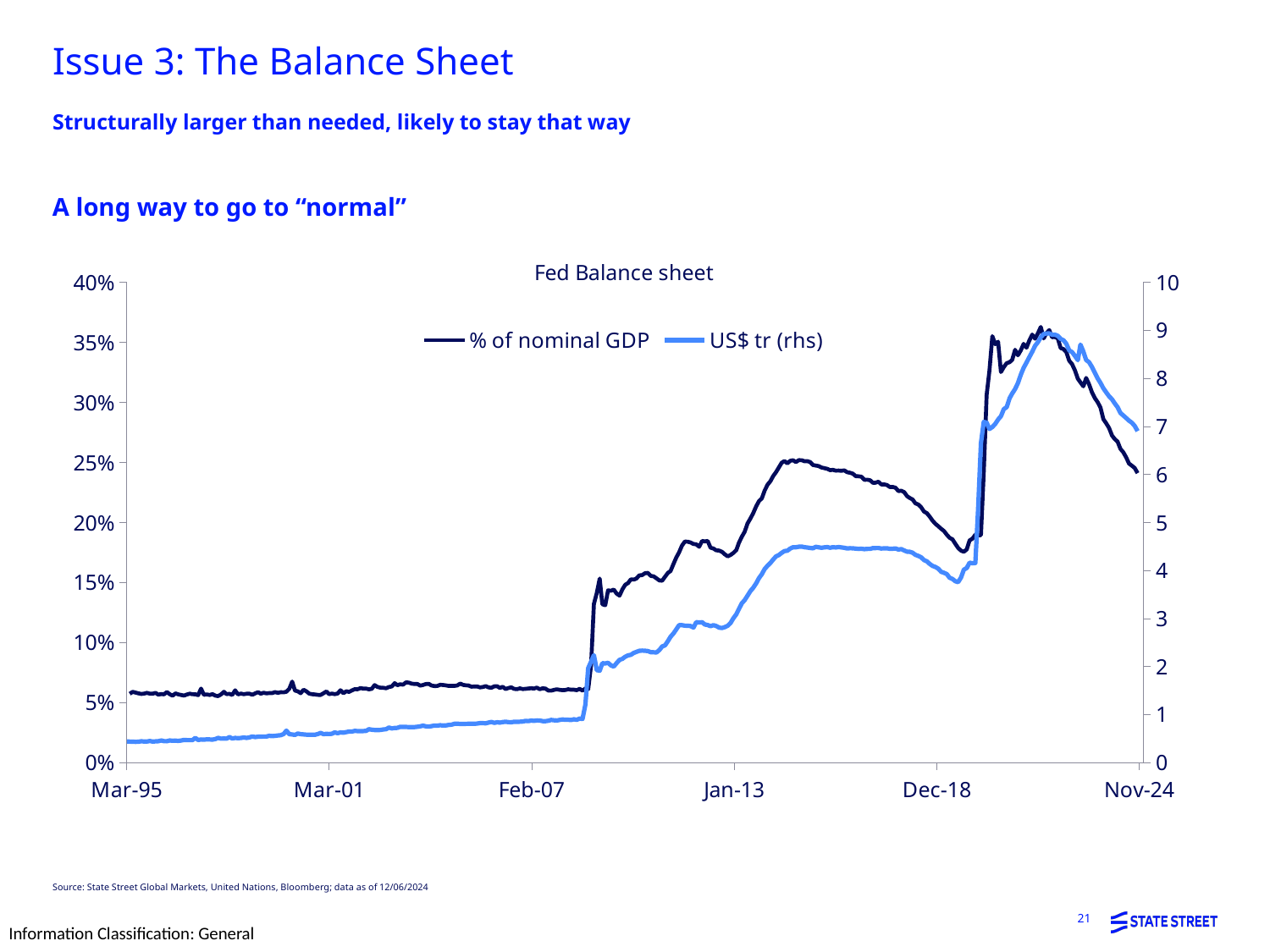
Is the value for US$ tr (rhs) at Mar-95 greater or less than 1? less Is the peak value of the % of nominal GDP series greater or less than 30%? greater How many date labels are shown on the x axis? 6 Is the value for % of nominal GDP at Mar-95 greater or less than 10%? less Which series is plotted against the right-hand axis? US$ tr (rhs) Does the US$ tr (rhs) series rise or fall between Mar-95 and Nov-24 overall? Rise What kind of chart is shown on the slide? Line chart What is the title of the chart? Fed Balance sheet How many series does the legend of the Fed Balance sheet chart list? 2